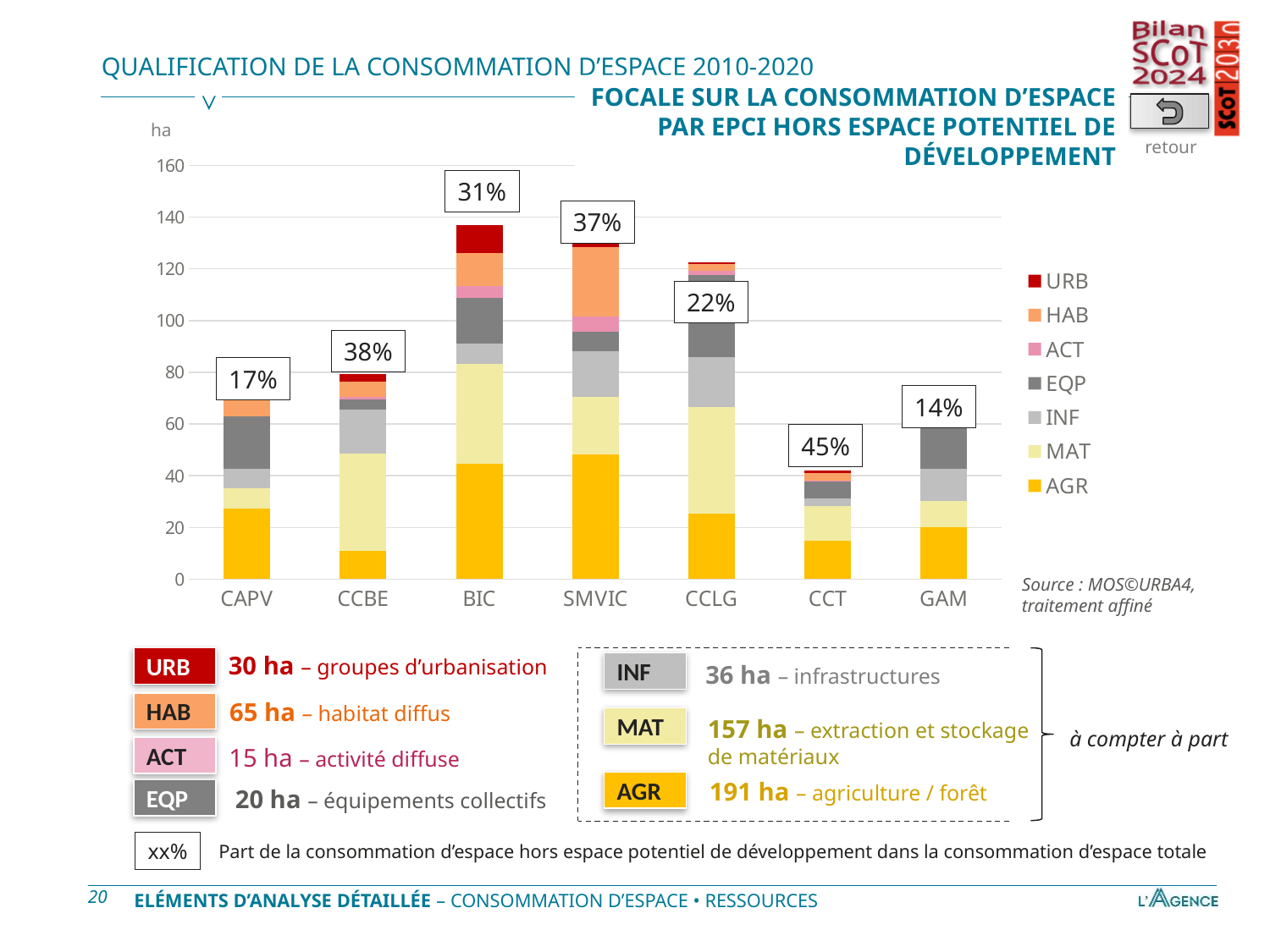
How many series does the chart legend list? 7 Which EPCI has the highest percentage label above its bar? CCT What percentage label is shown above the bar for CCBE? 38% What kind of chart is shown on the slide? Stacked bar chart What percentage label is shown above the bar for GAM? 14% What percentage label is shown above the bar for CCT? 45% Which EPCI has the lowest percentage label above its bar? GAM How many EPCI categories are shown on the x axis of the chart? 7 Which series is shown in red at the top of the legend? URB Is the total bar height for CCT greater or less than 60 ha? less Is the total bar height for BIC greater or less than 120 ha? greater Which EPCI has the shortest stacked bar in the chart? CCT